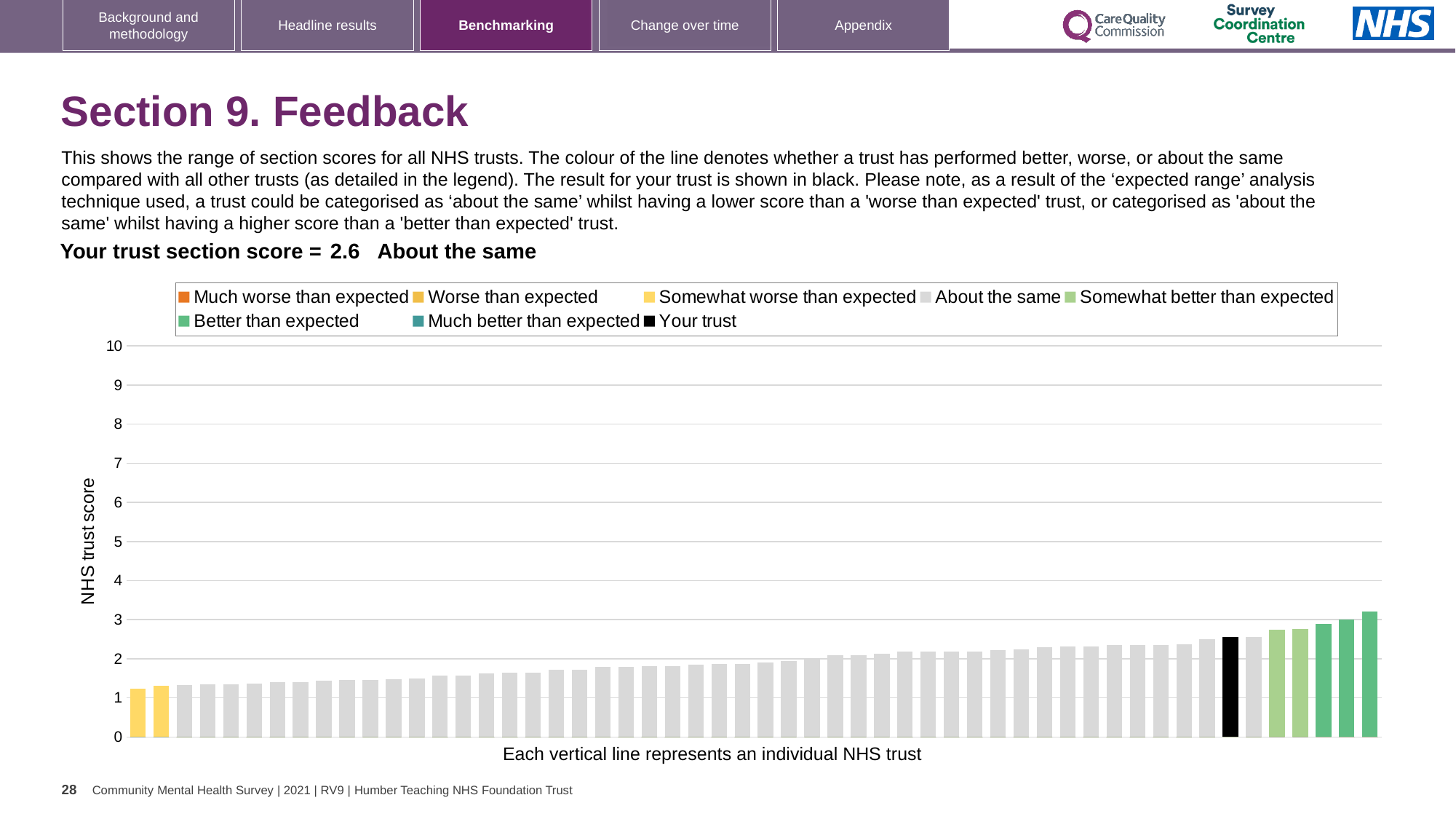
What is the section score for your trust shown on the slide? 2.6 Is the value of the tallest bar greater or less than 4? less What is the label of the y axis? NHS trust score Is the value of the black bar (your trust) greater or less than 3? less How many bars are coloured yellow (somewhat worse than expected)? 2 Is the value of the shortest bar greater or less than 2? less What kind of chart is shown on the slide? bar chart What colour is used for the bar representing your trust? black Do the bar values rise or fall from left to right along the x axis? rise How many entries does the chart legend list? 8 How is your trust's section score categorised compared with other trusts? About the same